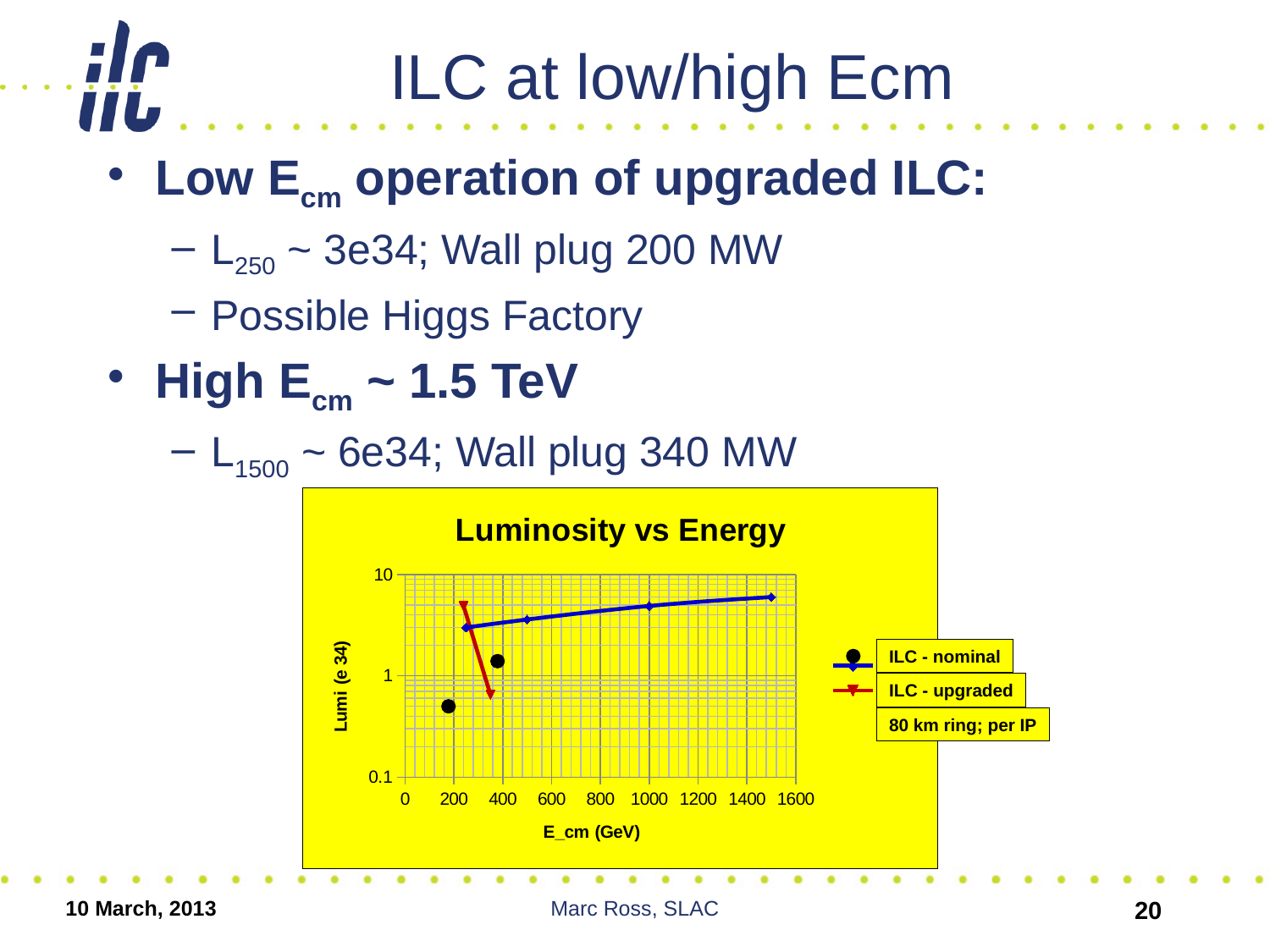
How many data points are plotted for the ILC - nominal series? 2 What is the label of the x axis of the chart? E_cm (GeV) Is the luminosity of the ILC - upgraded series at 1500 GeV greater or less than 1? greater What is the title of the chart? Luminosity vs Energy Is the luminosity of the ILC - upgraded series at 500 GeV greater or less than 1? greater Is the lowest ILC - nominal point greater or less than 1 on the luminosity axis? less Does the luminosity of the ILC - upgraded series rise or fall as E_cm increases? rise How many series does the legend of the chart list? 3 Does the luminosity of the 80 km ring; per IP series rise or fall as E_cm increases? fall What type of chart is shown on the slide? line chart How many data points are plotted for the ILC - upgraded series? 4 At around 250 GeV, which series has the higher luminosity: ILC - upgraded or ILC - nominal? ILC - upgraded